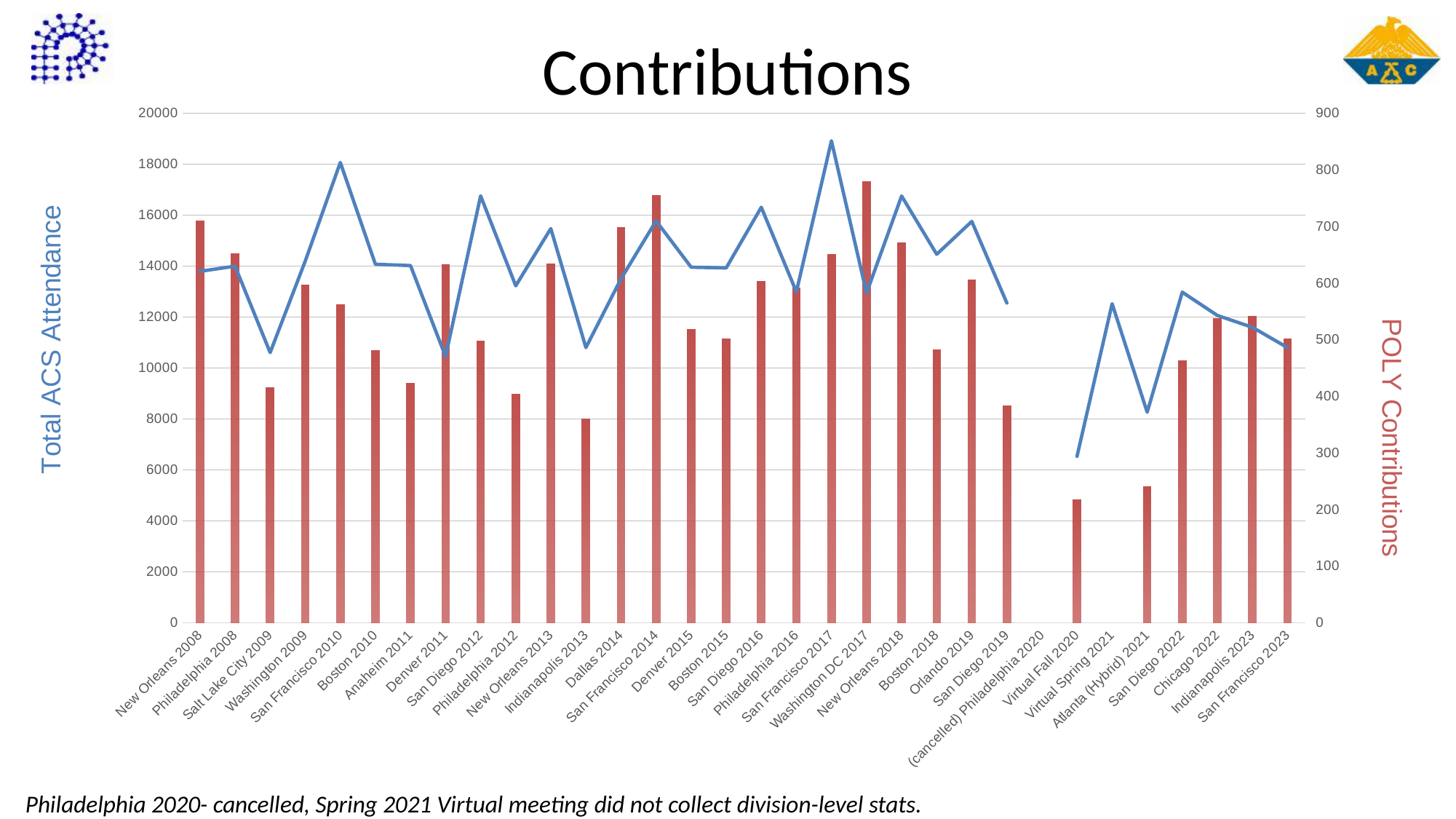
What is the title of the chart? Contributions Which has the larger POLY Contributions bar, Washington DC 2017 or Boston 2018? Washington DC 2017 Is the Total ACS Attendance for San Francisco 2010 greater or less than 16000? greater Which meeting has the highest Total ACS Attendance on the line? San Francisco 2017 Does the Total ACS Attendance line rise or fall from Chicago 2022 to San Francisco 2023? fall What is the label of the right-hand vertical axis? POLY Contributions What kind of chart is shown on the slide? A combined bar and line chart Is the POLY Contributions value for Virtual Fall 2020 greater or less than 300? less Which meeting has the highest POLY Contributions bar? Washington DC 2017 Is the POLY Contributions value for Washington DC 2017 greater or less than 700? greater Which meeting has the lowest Total ACS Attendance point on the line? Virtual Fall 2020